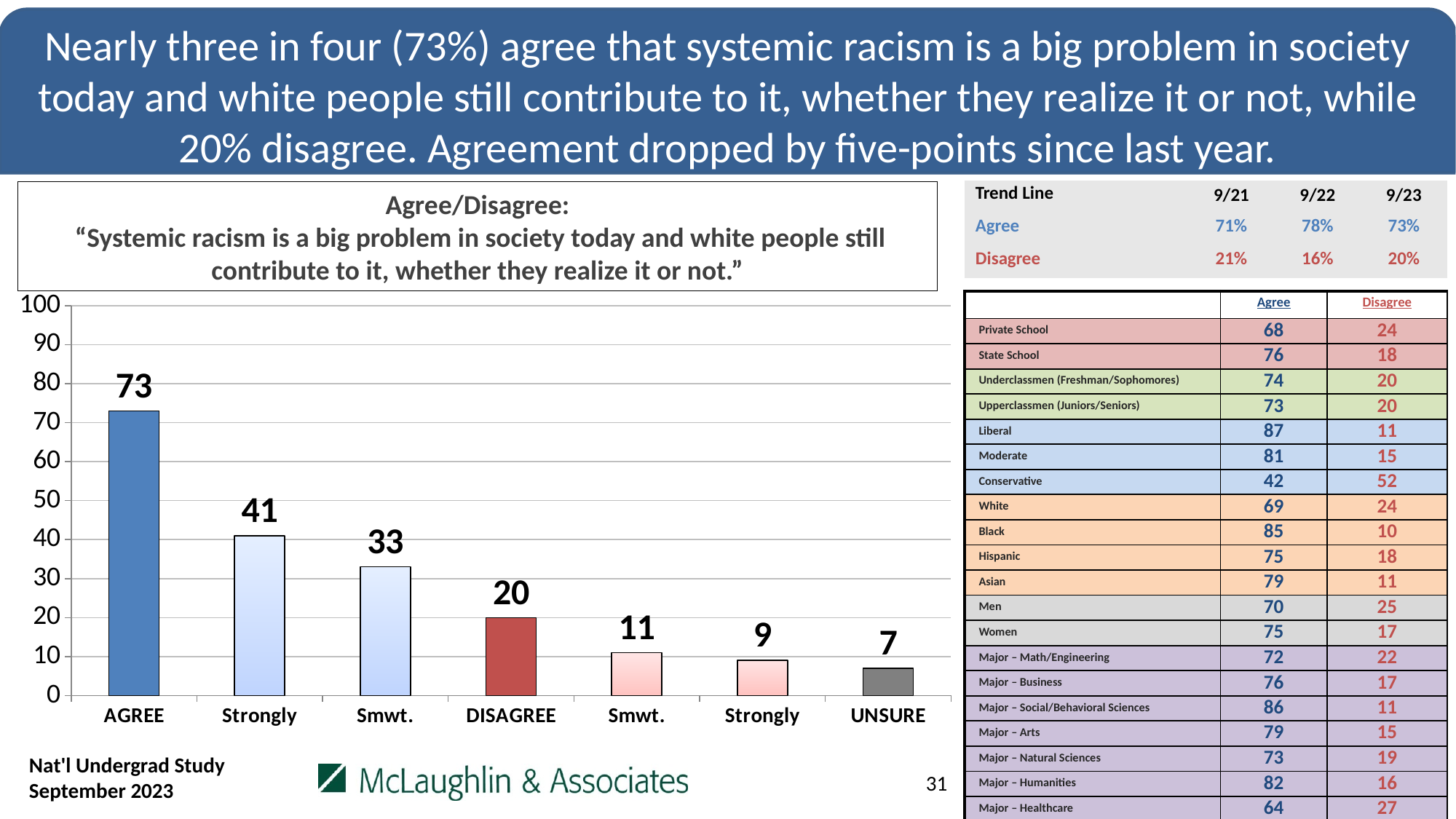
What kind of chart is shown on the slide? bar chart What is the maximum value shown on the vertical axis? 100 Which category has the lowest bar? UNSURE Which is larger, the Smwt. bar under AGREE or the Smwt. bar under DISAGREE? Smwt. under AGREE Which category has the highest bar? AGREE What is the value of the DISAGREE bar? 20 How many bars are shown in the chart? 7 What is the value of the AGREE bar? 73 What is the value of the UNSURE bar? 7 Is the value for the Strongly bar under DISAGREE greater or less than 10? less What is the value of the Strongly bar next to AGREE? 41 What is the difference between the AGREE and DISAGREE bars? 53